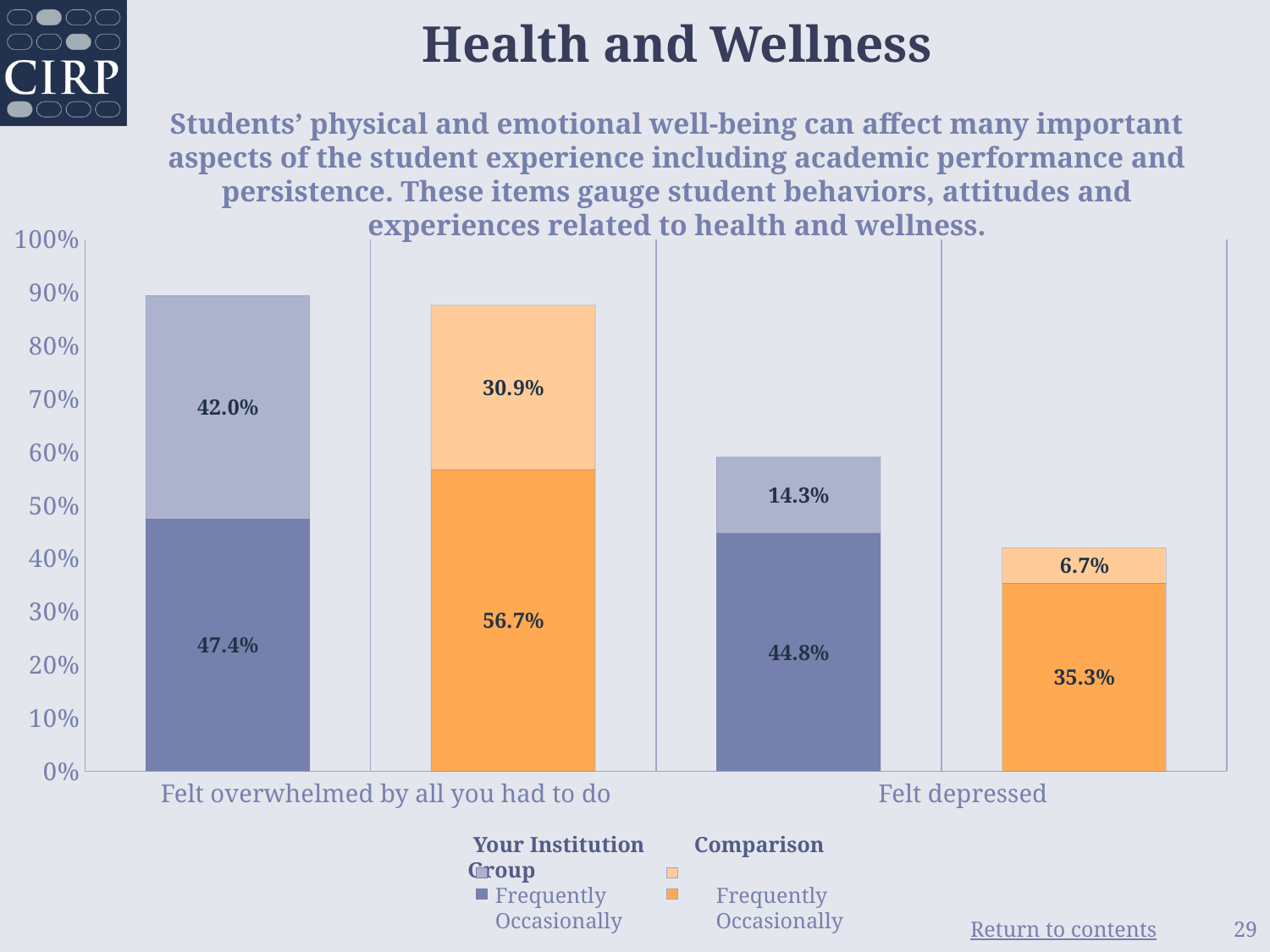
What is the total stacked value (Frequently plus Occasionally) for Your Institution on 'Felt overwhelmed by all you had to do'? 89.4% What is the difference between the Comparison Group's and Your Institution's 'Frequently' values for 'Felt overwhelmed by all you had to do'? 9.3% What percentage of students at Your Institution reported occasionally feeling depressed? 14.3% What percentage of students in the Comparison Group reported occasionally feeling depressed? 6.7% How many series does the chart's legend list? 4 Is the total stacked bar for the Comparison Group on 'Felt depressed' greater or less than 50%? less Which is larger for 'Felt depressed': the 'Frequently' value for Your Institution or for the Comparison Group? Your Institution What percentage of students in the Comparison Group reported frequently feeling overwhelmed by all they had to do? 56.7% How many categories are shown on the x axis of the chart? 2 What percentage of students at Your Institution reported frequently feeling overwhelmed by all they had to do? 47.4% What is the total stacked value (Frequently plus Occasionally) for the Comparison Group on 'Felt depressed'? 42.0% What kind of chart is shown on the slide? Stacked bar chart